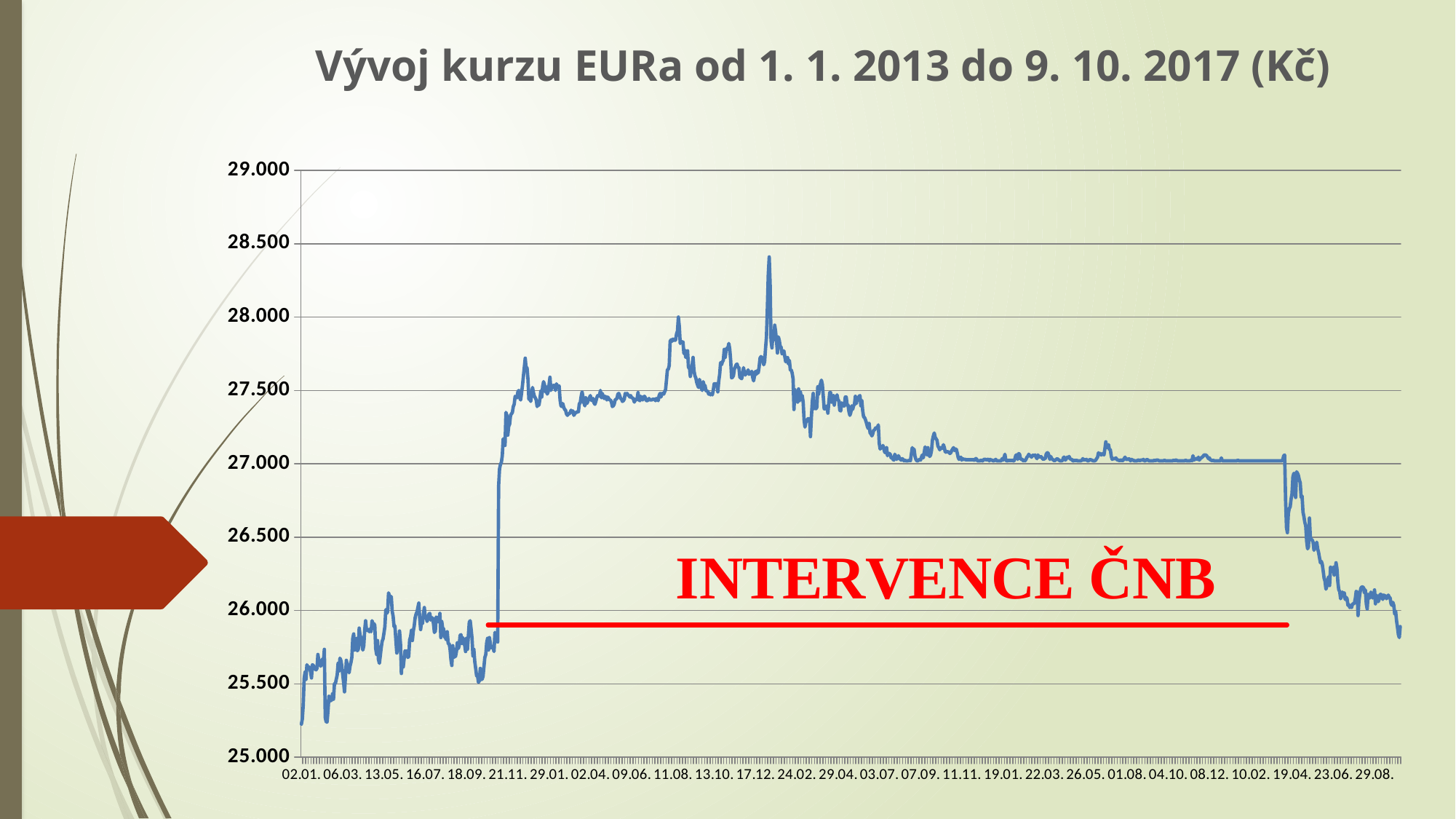
Is the value at the end of the series (after 29.08.) greater or less than 26.500? less Is the value at the start of the series (02.01.) greater or less than 25.500? less What is the title of the chart? Vývoj kurzu EURa od 1. 1. 2013 do 9. 10. 2017 (Kč) From 19.04. to the end of the series, do the values rise or fall? fall Is the value at 18.09. greater or less than 26.500? less What kind of chart is shown on the slide? line chart Around 21.11., does the line rise or fall sharply? rise What red text annotation is written across the chart? INTERVENCE ČNB